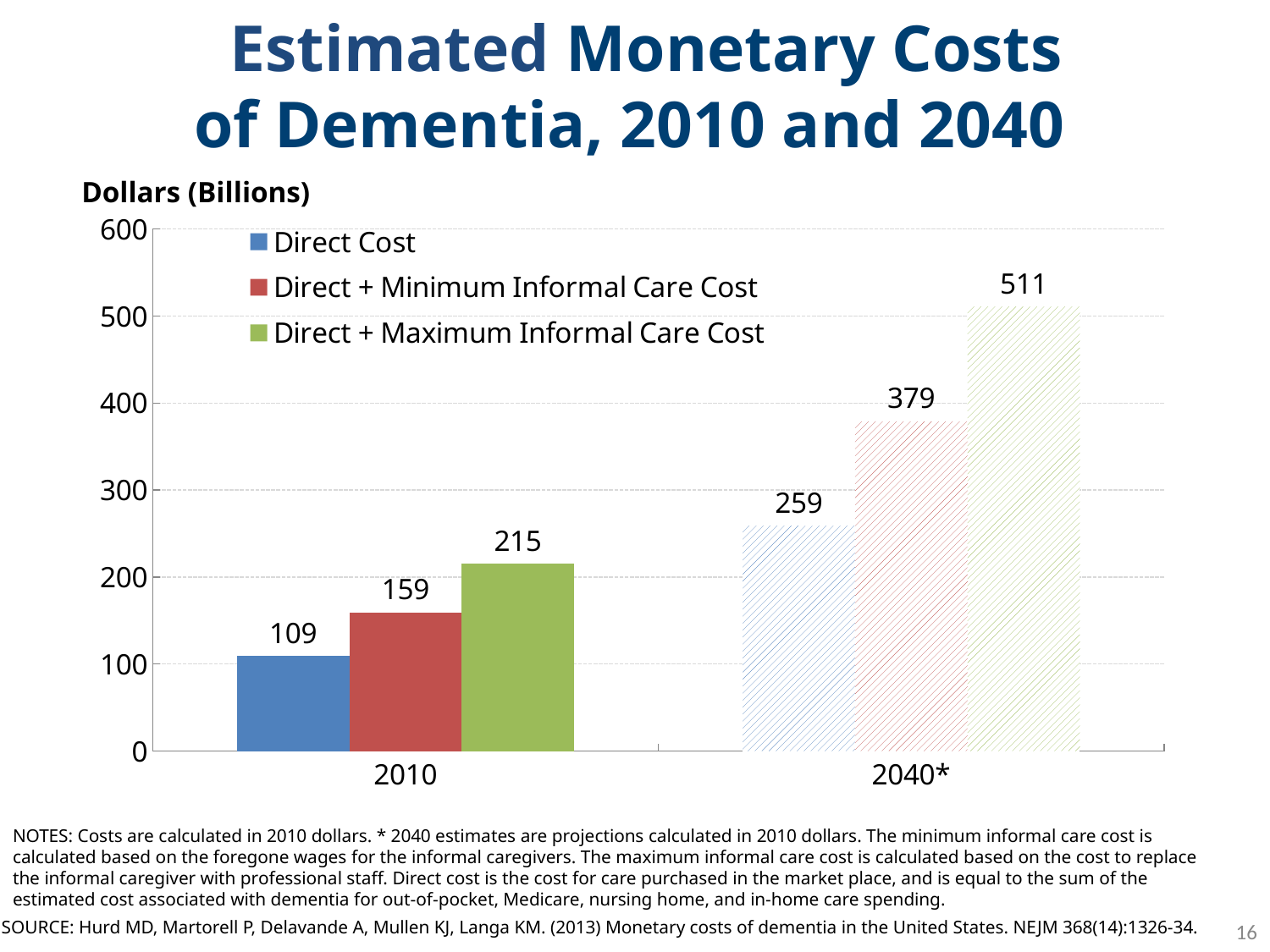
Which series has the lowest value in 2010? Direct Cost What is the difference between the Direct + Maximum Informal Care Cost values for 2040* and 2010? 296 Which series has the highest value in 2040*? Direct + Maximum Informal Care Cost What is the Direct + Maximum Informal Care Cost value for 2040*? 511 What is the Direct Cost value for 2010? 109 What unit is given for the y axis? Dollars (Billions) How many year categories are shown on the x axis? 2 What is the difference between the Direct Cost and Direct + Minimum Informal Care Cost values in 2010? 50 What is the Direct + Minimum Informal Care Cost value for 2040*? 379 Which is larger: the Direct Cost for 2040* or the Direct + Maximum Informal Care Cost for 2010? Direct Cost for 2040* What kind of chart is shown on the slide? Bar chart How many series does the legend list? 3